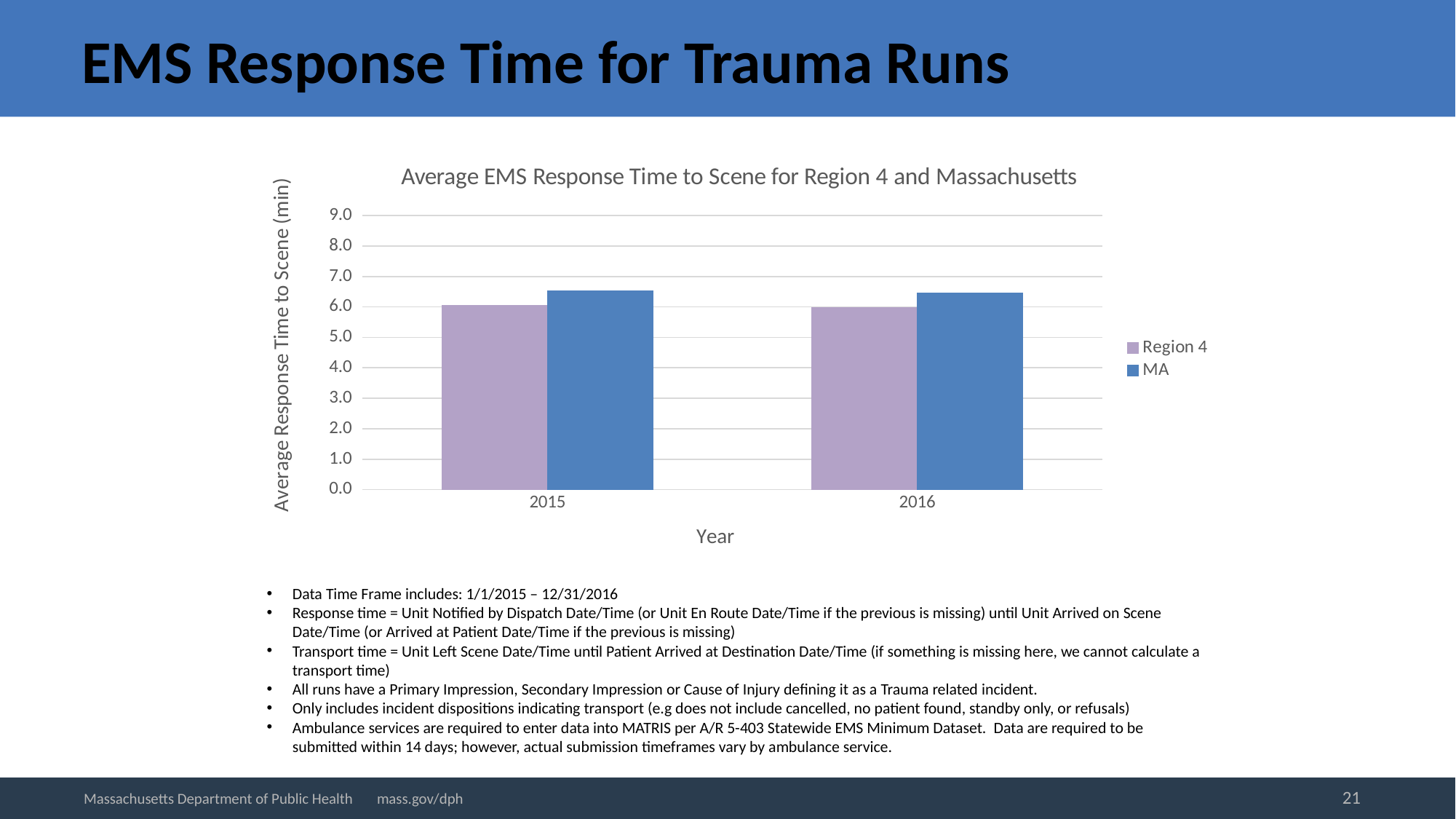
Is the value for MA in 2015 greater or less than 6.0? greater Is the value for Region 4 in 2015 greater or less than 7.0? less Which series has the larger value in 2016, Region 4 or MA? MA Is the value for Region 4 in 2016 greater or less than 5.0? greater How many series does the legend list? 2 How many years are shown on the x axis? 2 What kind of chart is shown on the slide? Bar chart What is the title of the chart? Average EMS Response Time to Scene for Region 4 and Massachusetts What is the label of the vertical axis? Average Response Time to Scene (min) Which series has the larger value in 2015, Region 4 or MA? MA